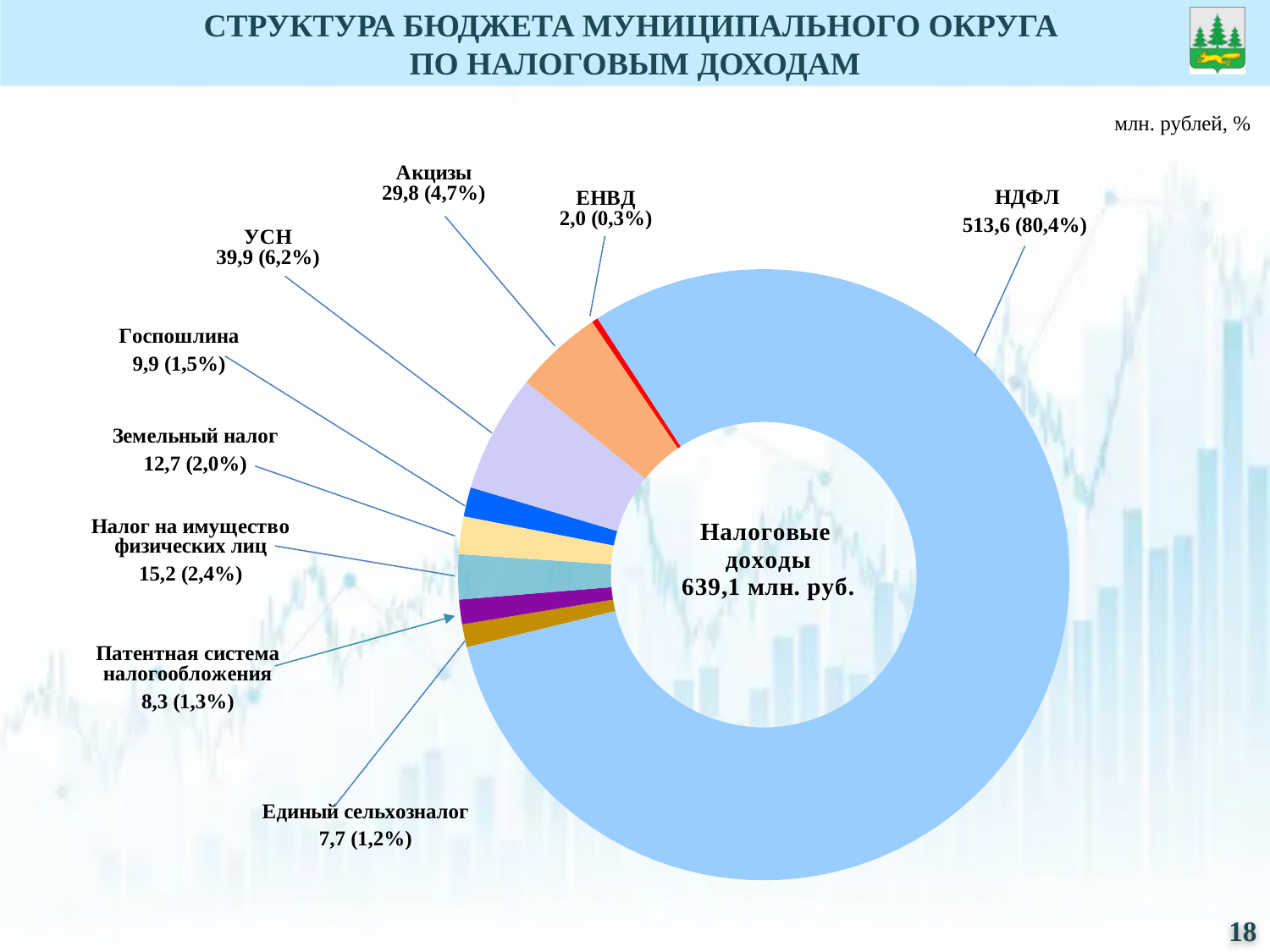
What is the value for НДФЛ in млн. рублей? 513,6 What is the title of the slide? СТРУКТУРА БЮДЖЕТА МУНИЦИПАЛЬНОГО ОКРУГА ПО НАЛОГОВЫМ ДОХОДАМ Which category has the largest share of tax revenues? НДФЛ What type of chart is shown on the slide? Pie (donut) chart How many categories are shown in the chart? 9 What is the value for Акцизы in млн. рублей? 29,8 What is the total of tax revenues shown in the centre of the chart? 639,1 млн. руб. What share of tax revenues does Патентная система налогообложения account for? 1,3% What share of tax revenues does УСН account for? 6,2% Which is larger: Земельный налог or Госпошлина? Земельный налог Which category has the smallest share of tax revenues? ЕНВД What is the difference in млн. рублей between УСН and Акцизы? 10,1